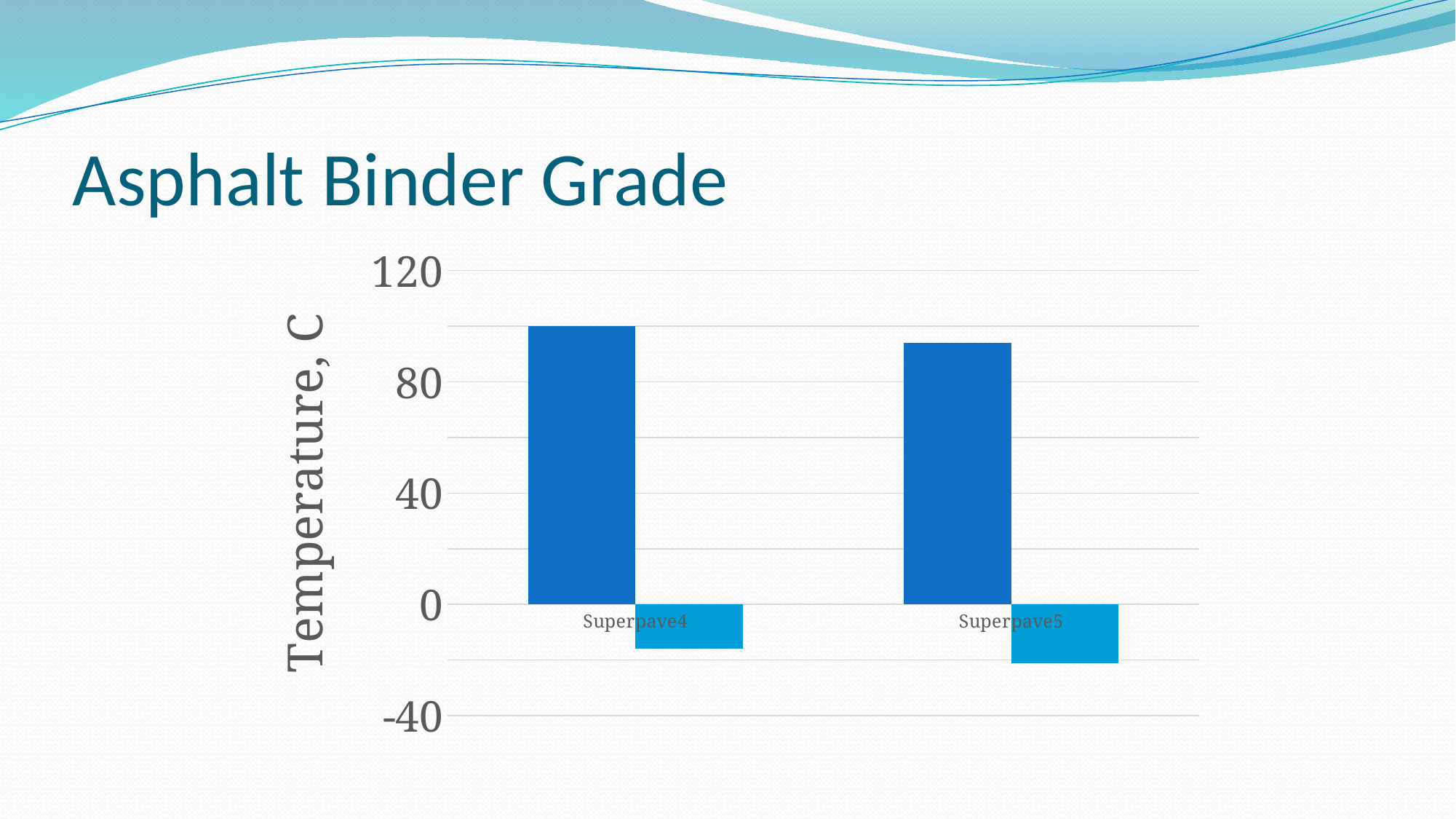
What is the label on the vertical axis of the chart? Temperature, C Is the value of the dark blue bar for Superpave4 greater or less than 80? greater How many categories are shown on the x axis of the chart? 2 How many bars are plotted for each category? 2 Which category has the highest dark blue bar? Superpave4 Is the value of the light blue bar for Superpave4 greater or less than 0? less What is the title of the slide containing the chart? Asphalt Binder Grade Which category has the lower light blue bar value, Superpave4 or Superpave5? Superpave5 Is the value of the dark blue bar for Superpave5 greater or less than 80? greater What type of chart is shown on the slide? bar chart Which category has the taller dark blue bar, Superpave4 or Superpave5? Superpave4